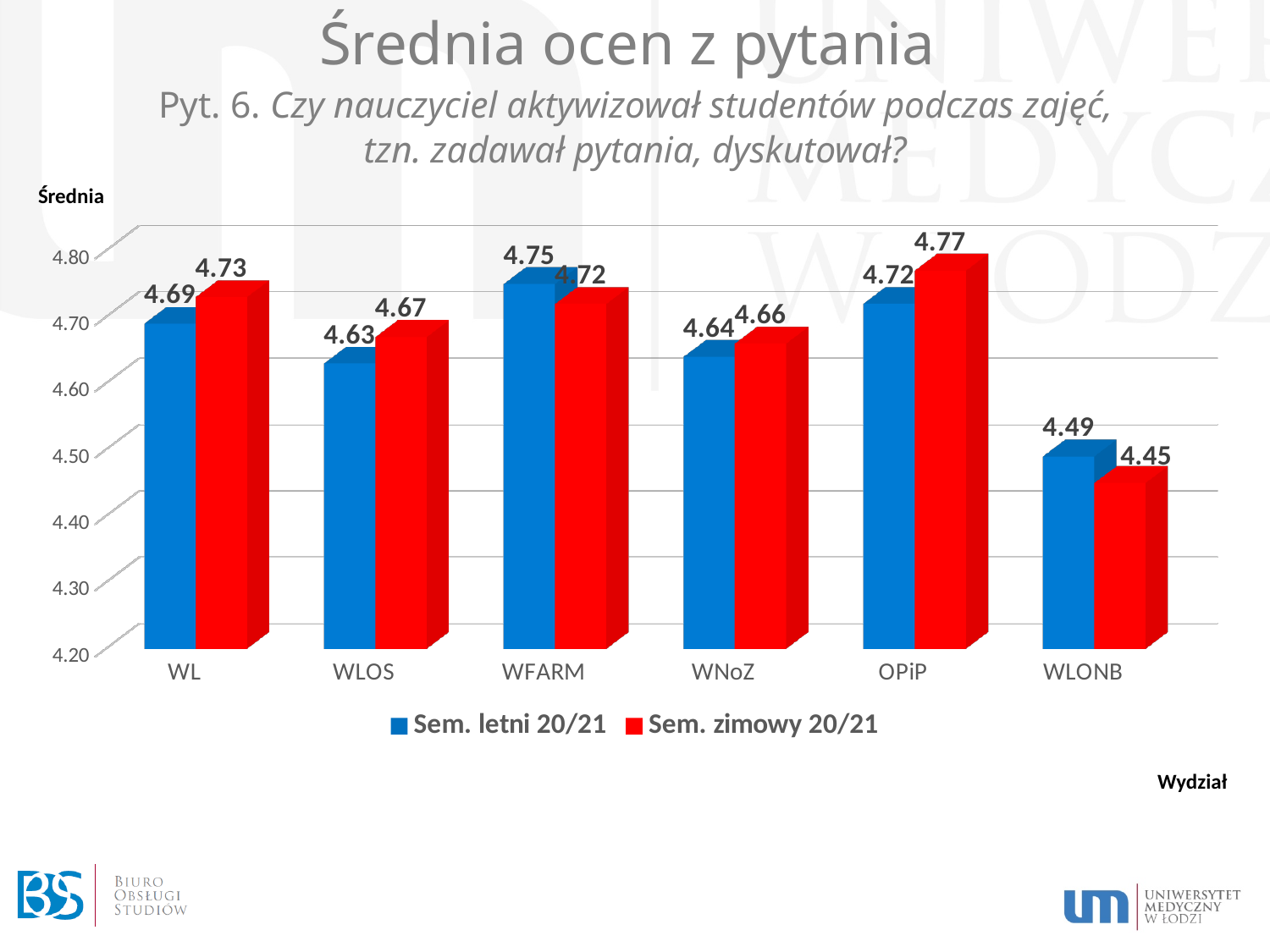
What kind of chart is shown on the slide? Bar chart How many faculties are shown on the x axis? 6 For WFARM, which series has the larger value: Sem. letni 20/21 or Sem. zimowy 20/21? Sem. letni 20/21 What is the value for OPiP in the Sem. zimowy 20/21 series? 4.77 What is the difference between the Sem. zimowy 20/21 and Sem. letni 20/21 values for OPiP? 0.05 What is the value for WL in the Sem. letni 20/21 series? 4.69 How many series does the legend list? 2 What is the value for WLONB in the Sem. letni 20/21 series? 4.49 Which faculty has the lowest value in the Sem. letni 20/21 series? WLONB Which colour represents the Sem. zimowy 20/21 series? Red Which faculty has the highest value in the Sem. zimowy 20/21 series? OPiP What is the value for WFARM in the Sem. zimowy 20/21 series? 4.72